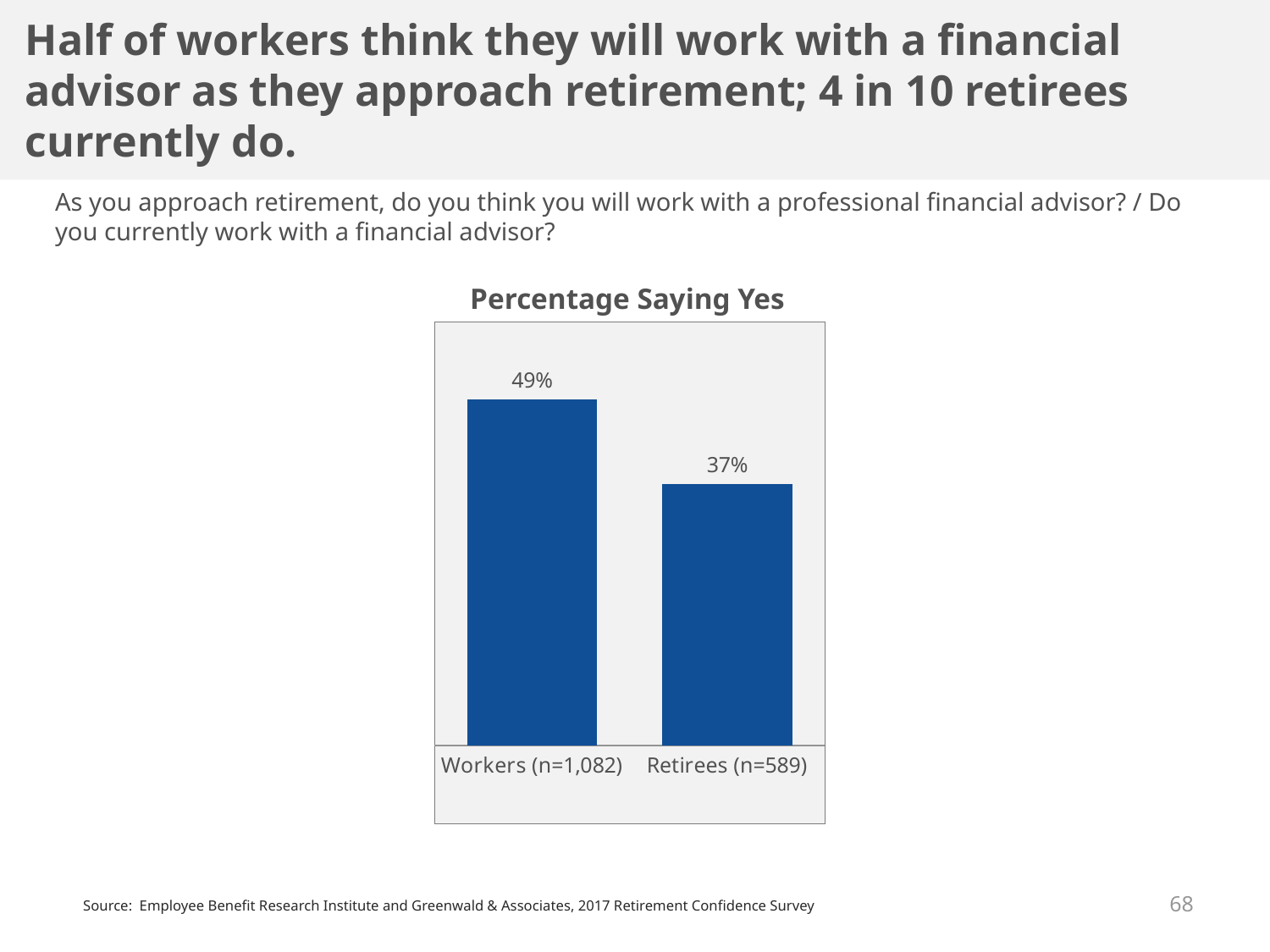
Which group has the higher percentage saying yes? Workers (n=1,082) Do the values rise or fall from Workers to Retirees? fall What is the title of the chart? Percentage Saying Yes What is the difference in percentage points between workers and retirees saying yes? 12 What is the sample size for the Workers category? 1,082 How many categories are shown in the chart? 2 What kind of chart is shown on the slide? bar chart Is the value for workers larger or smaller than the value for retirees? larger What percentage of workers say yes? 49% Which group has the lower percentage saying yes? Retirees (n=589) What percentage of retirees say yes? 37%